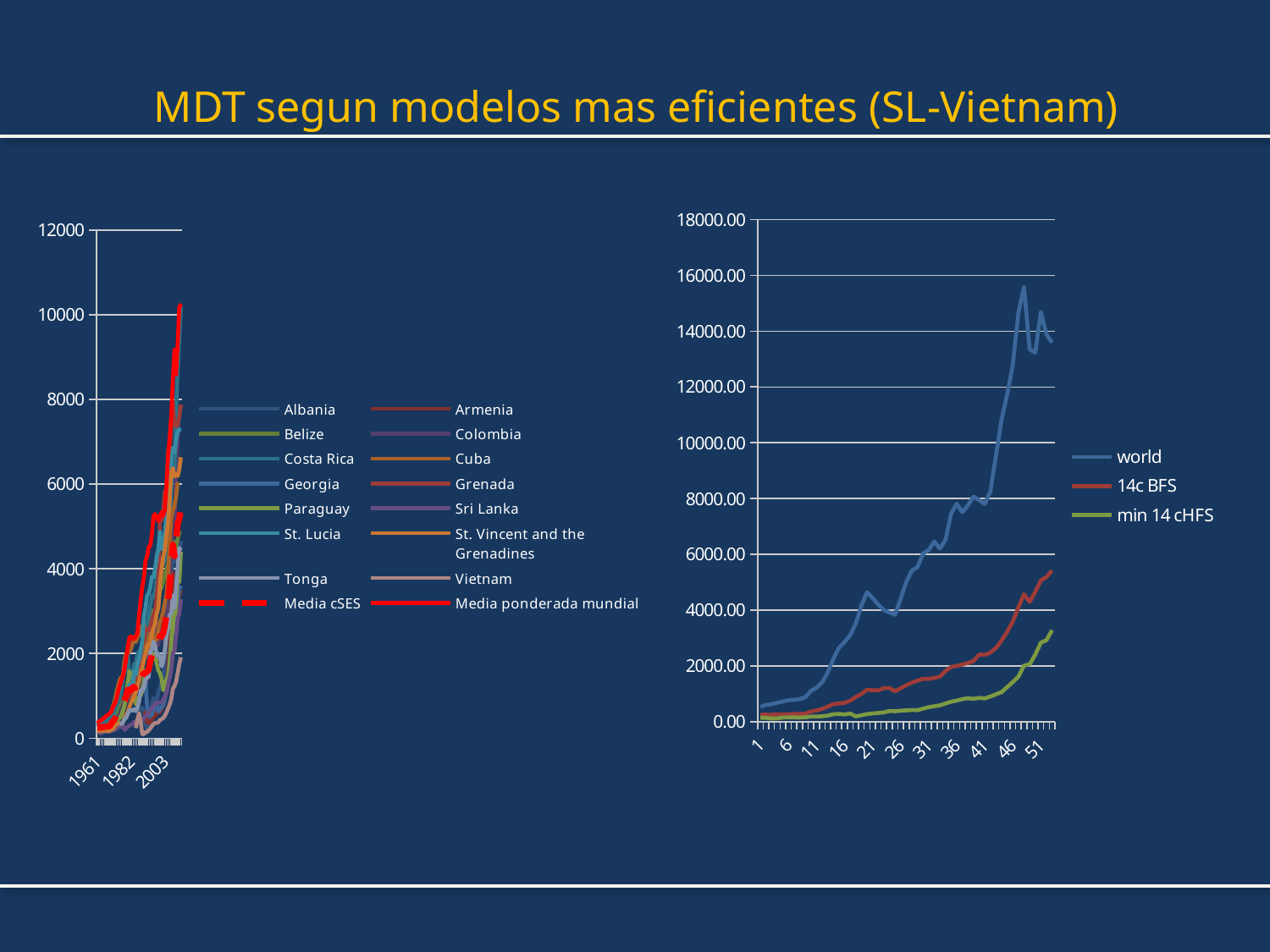
In the right chart, is the final value of the min 14 cHFS series greater or less than 4000.00? less In the right chart, does the min 14 cHFS series generally rise or fall along the x axis? rise In the right chart, is the highest value of the world series greater or less than 14000.00? greater What is the highest value shown on the y axis of the right chart? 18000.00 In the right chart, at the last point on the x axis, which series is larger: world or 14c BFS? world How many series does the legend of the left chart list? 16 In the left chart, which legend entry is drawn with a dashed line? Media cSES How many series does the legend of the right chart list? 3 In the left chart, is the highest value of the Media ponderada mundial series greater or less than 8000? greater What kind of chart is the chart on the left of the slide? line chart What kind of chart is the chart on the right of the slide? line chart